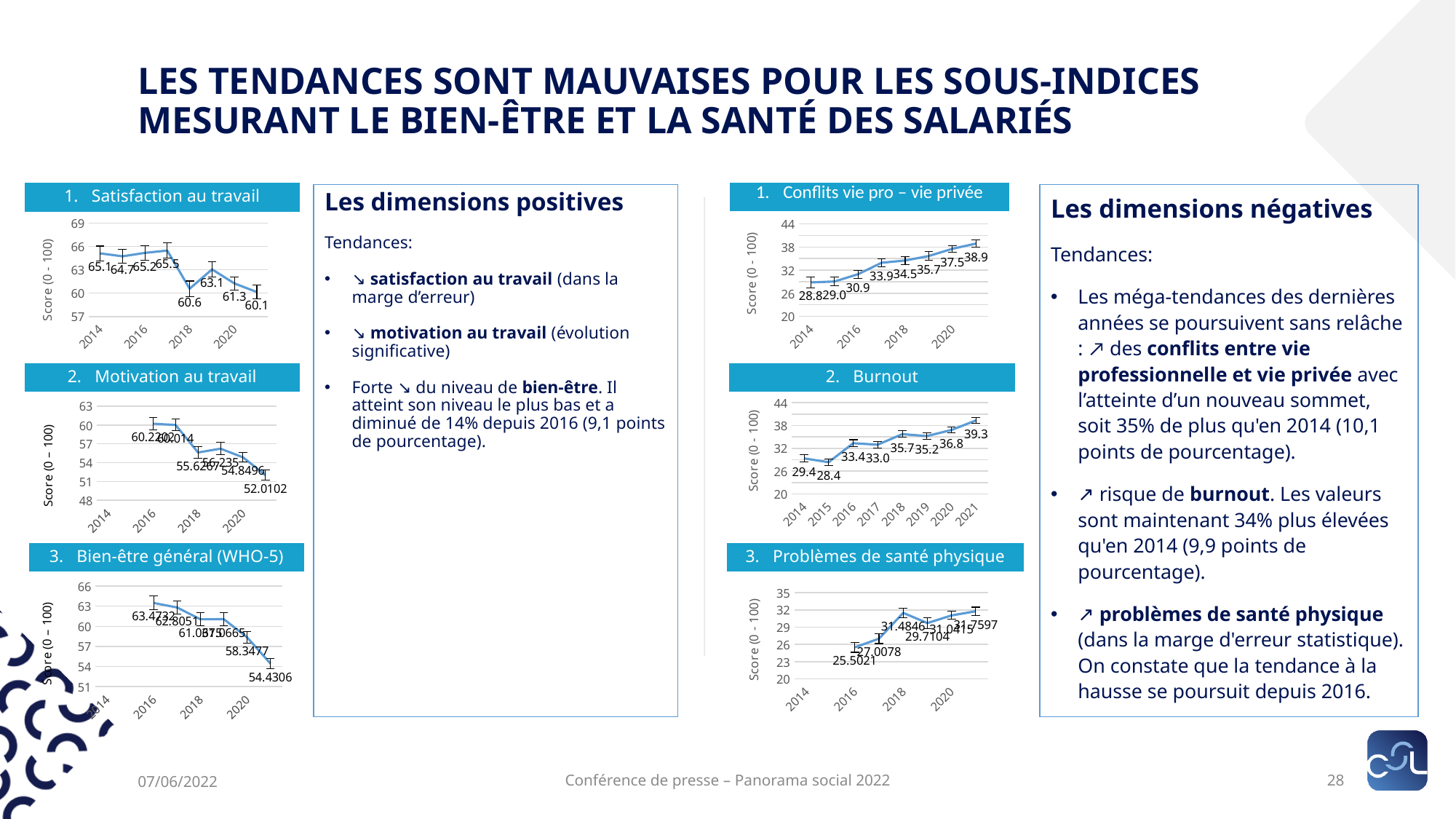
In the 'Motivation au travail' chart, what is the lowest value shown? 52.0102 What kind of chart is the 'Burnout' chart? line chart In the 'Satisfaction au travail' chart, what is the value for 2021? 60.1 In the 'Burnout' chart, what is the difference between the 2021 value and the 2015 value? 10.9 In the 'Satisfaction au travail' chart, what is the highest value shown? 65.5 How many data points are plotted in the 'Burnout' chart? 8 In the 'Burnout' chart, which year has the lowest value? 2015 In the 'Problèmes de santé physique' chart, which is larger: the first plotted value (25.5021) or the last plotted value (31.7597)? the last value (31.7597) In the 'Conflits vie pro – vie privée' chart, what is the value for 2014? 28.8 In the 'Burnout' chart, what is the value for 2021? 39.3 In the 'Bien-être général (WHO-5)' chart, is the last plotted value greater or less than 57? less In the 'Conflits vie pro – vie privée' chart, do the values rise or fall from 2014 to 2021? rise